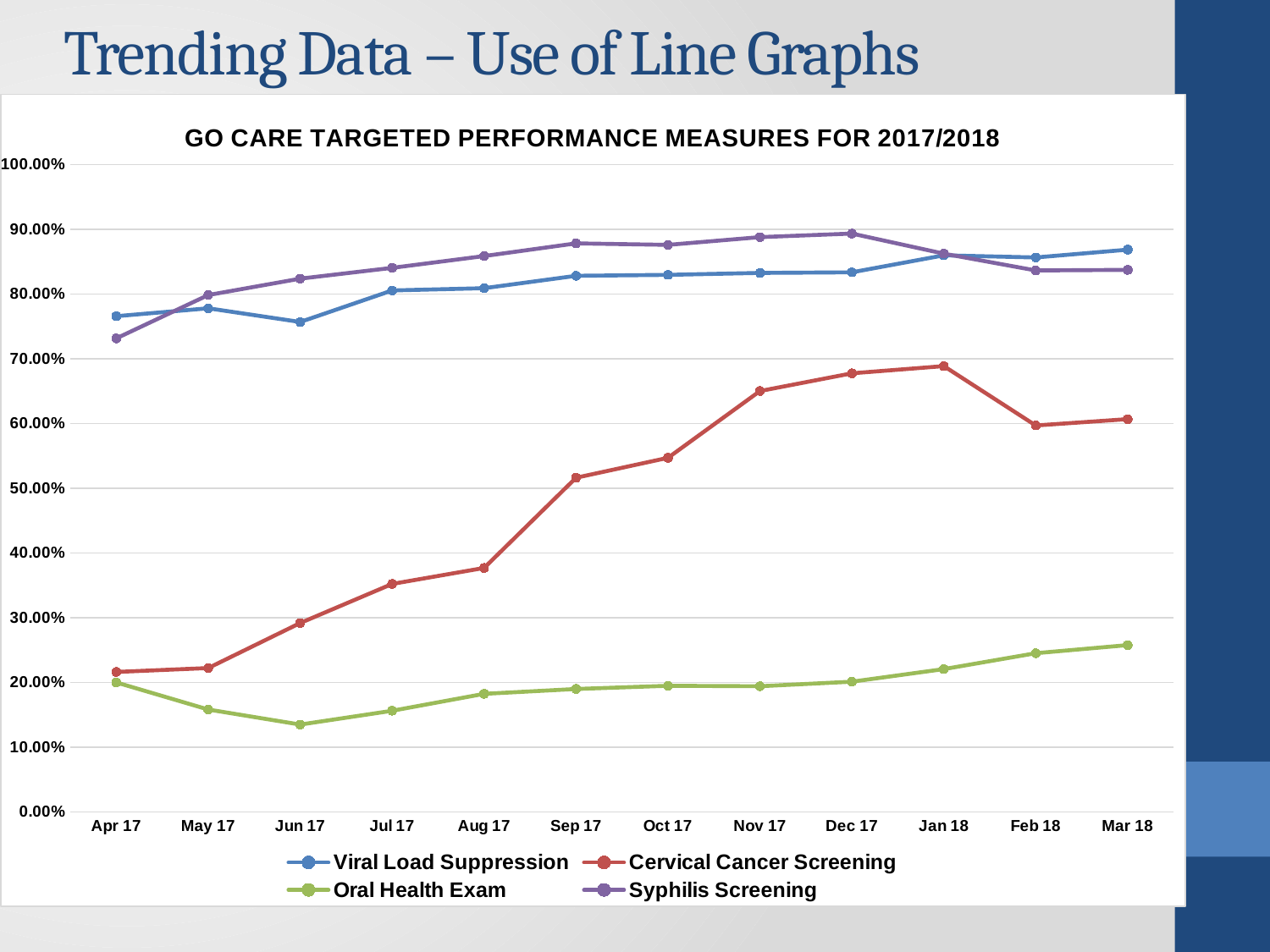
Is the value for Syphilis Screening in Dec 17 greater or less than 80.00%? greater How many months are plotted along the x axis? 12 In Dec 17, which is higher: Cervical Cancer Screening or Oral Health Exam? Cervical Cancer Screening Is the value for Viral Load Suppression in Mar 18 greater or less than 80.00%? greater How many series does the legend list? 4 Is the value for Cervical Cancer Screening in Apr 17 greater or less than 30.00%? less Which series has the lowest values across the whole period? Oral Health Exam In which month is Oral Health Exam at its lowest? Jun 17 What is the title of the chart? GO CARE TARGETED PERFORMANCE MEASURES FOR 2017/2018 What kind of chart is shown on the slide? line chart Does Cervical Cancer Screening rise or fall from Apr 17 to Jan 18? rise